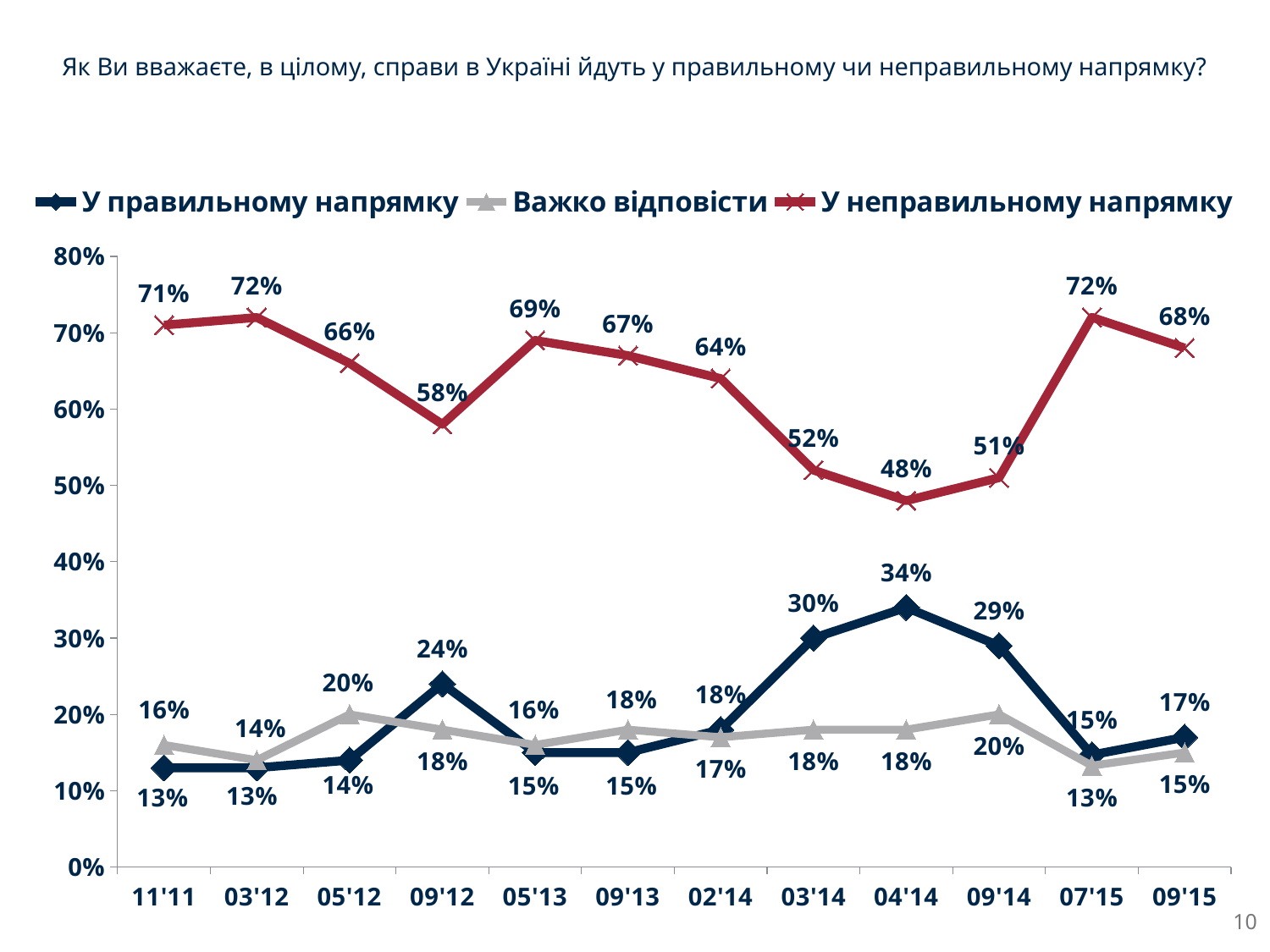
Which series is drawn in red? У неправильному напрямку At which time point does 'У правильному напрямку' reach its highest value? 04'14 What is the value for 'У неправильному напрямку' at 09'12? 58% What is the value for 'У правильному напрямку' at 03'14? 30% How many time points are shown on the x axis? 12 Which is larger at 05'12: 'Важко відповісти' or 'У правильному напрямку'? Важко відповісти What type of chart is shown on the slide? line chart What is the difference between 'У неправильному напрямку' and 'У правильному напрямку' at 09'15? 51% What is the value for 'Важко відповісти' at 07'15? 13% How many series does the legend list? 3 Does 'У неправильному напрямку' rise or fall between 04'14 and 07'15? rise At which time point does 'У неправильному напрямку' reach its lowest value? 04'14